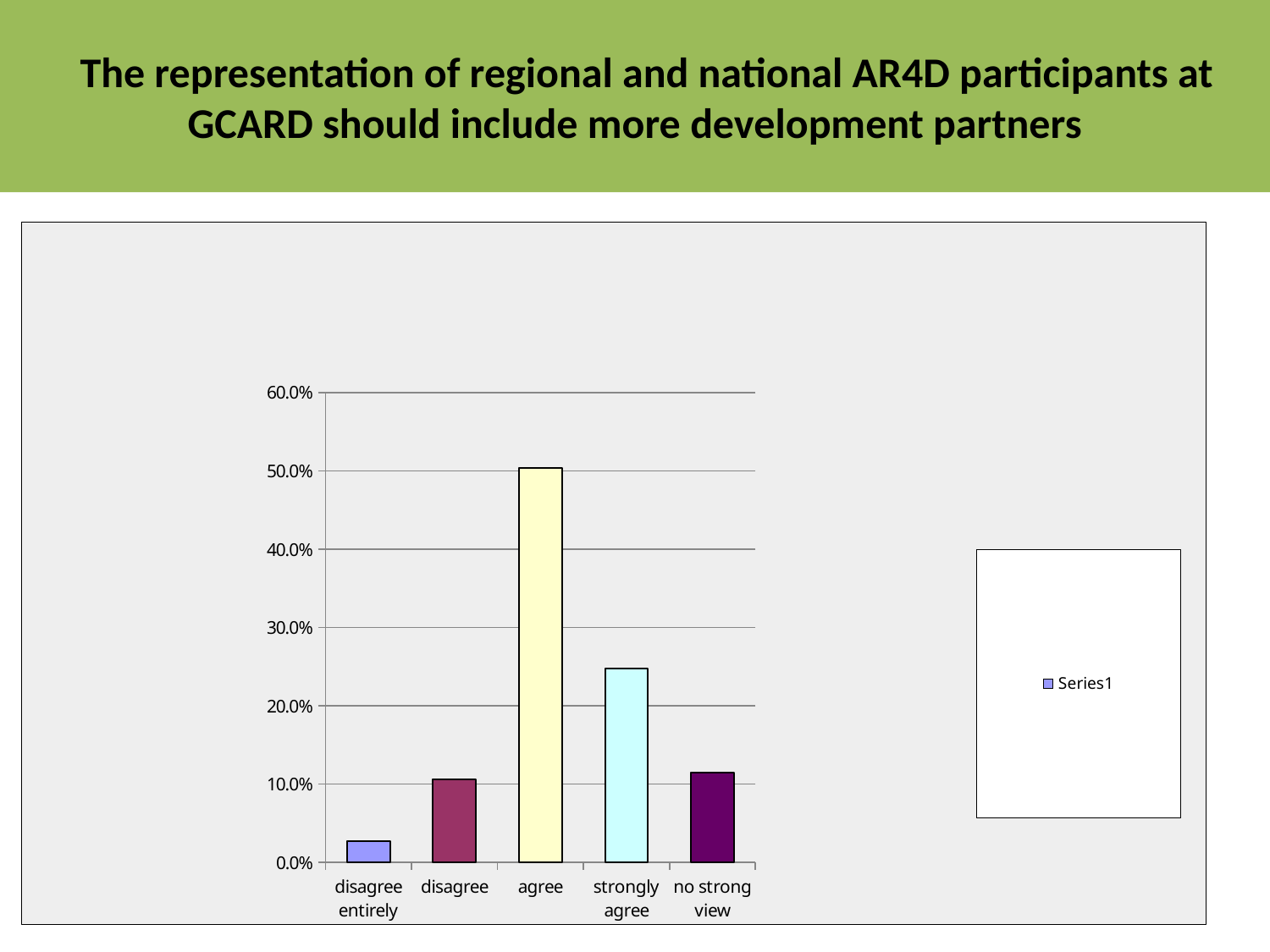
Is the value for strongly agree greater or less than 30.0%? less How many series does the chart legend list? 1 Is the value for agree greater or less than 40.0%? greater Is the value for disagree entirely greater or less than 10.0%? less Which category has the highest value in the chart? agree How many categories are shown on the x axis of the chart? 5 Which is larger, the value for strongly agree or the value for disagree? strongly agree Which category has the lowest value in the chart? disagree entirely What is the name of the series shown in the chart legend? Series1 What kind of chart is shown on the slide? bar chart Which is larger, the value for agree or the value for strongly agree? agree